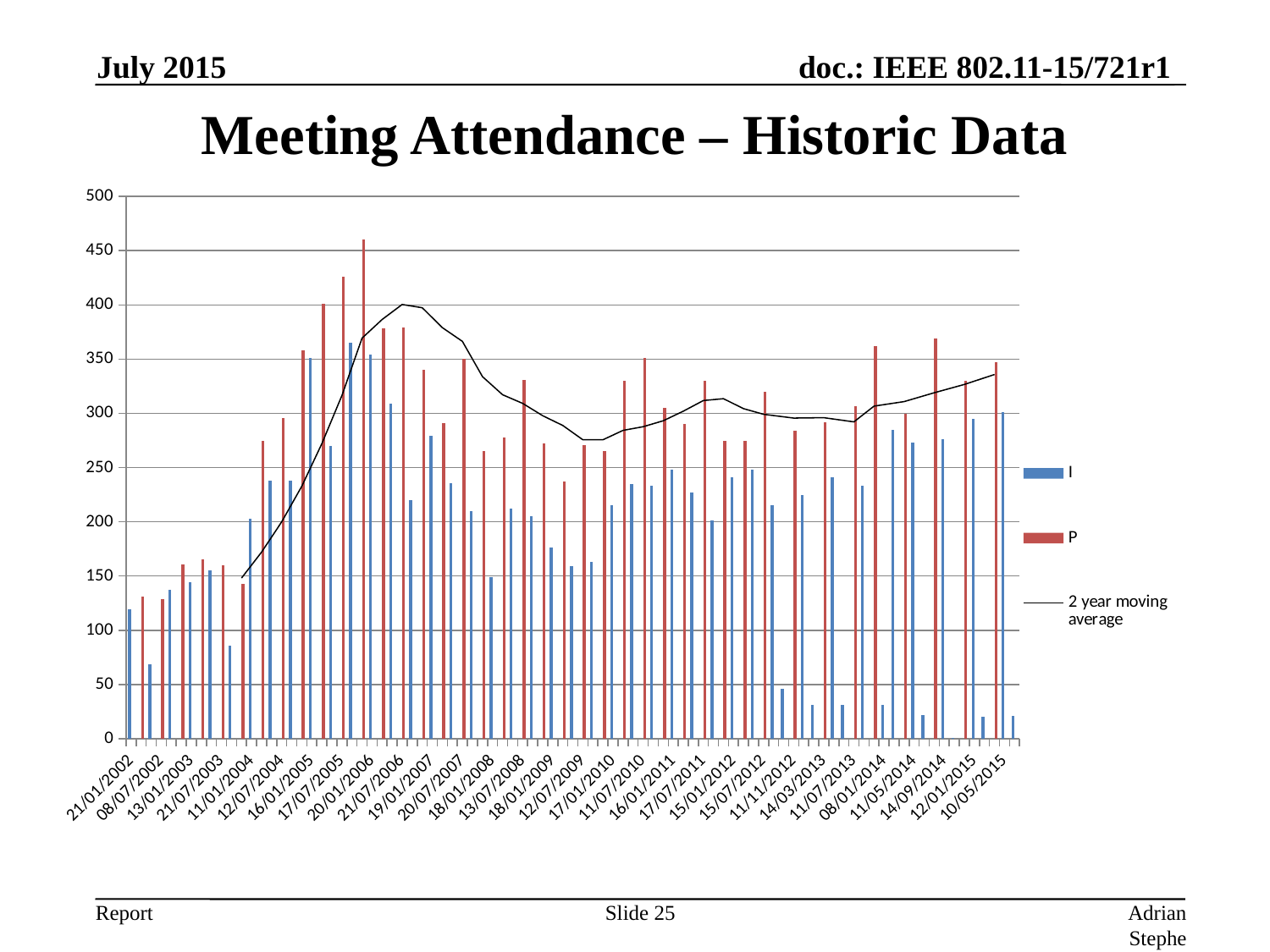
What is the title of the chart? Meeting Attendance – Historic Data Is the I value for 21/01/2002 greater or less than 150? less Is the tallest I bar on the chart greater or less than 350? greater Is the peak of the 2 year moving average line greater or less than 350? greater Which series, I or P, has the tallest bar on the chart? P What kind of chart is used to plot the I and P series? bar chart How many series does the legend list? 3 What is the highest value shown on the vertical axis? 500 Between its peak around 2006 and 2009, does the 2 year moving average line rise or fall? fall What are the three entries in the legend? I, P, 2 year moving average